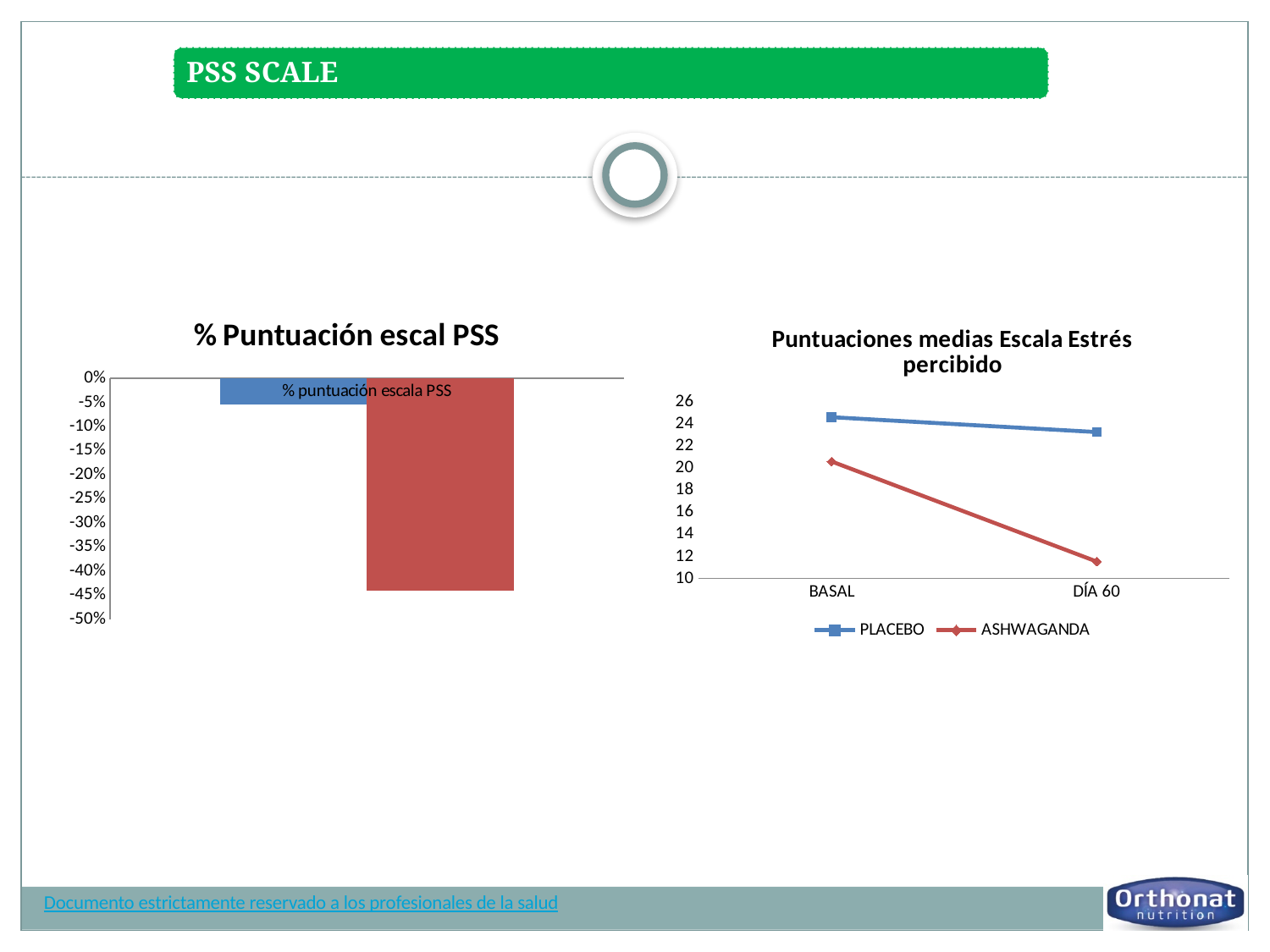
In the right chart 'Puntuaciones medias Escala Estrés percibido', is the ASHWAGANDA value at DÍA 60 greater or less than 14? less In the right chart 'Puntuaciones medias Escala Estrés percibido', does the ASHWAGANDA line rise or fall from BASAL to DÍA 60? fall In the right chart 'Puntuaciones medias Escala Estrés percibido', is the PLACEBO value at BASAL greater or less than 24? greater In the right chart 'Puntuaciones medias Escala Estrés percibido', what are the two series named in the legend? PLACEBO and ASHWAGANDA In the right chart 'Puntuaciones medias Escala Estrés percibido', how many categories are shown on the x axis? 2 In the left chart '% Puntuación escal PSS', is the value of the red bar greater or less than -40%? less In the right chart 'Puntuaciones medias Escala Estrés percibido', which series has the higher value at DÍA 60, PLACEBO or ASHWAGANDA? PLACEBO In the left chart '% Puntuación escal PSS', how many bars are plotted? 2 In the right chart 'Puntuaciones medias Escala Estrés percibido', how many series does the legend list? 2 What kind of chart is the right chart titled 'Puntuaciones medias Escala Estrés percibido'? line chart What kind of chart is the left chart titled '% Puntuación escal PSS'? bar chart In the left chart '% Puntuación escal PSS', which bar shows the larger decrease, the blue bar or the red bar? the red bar